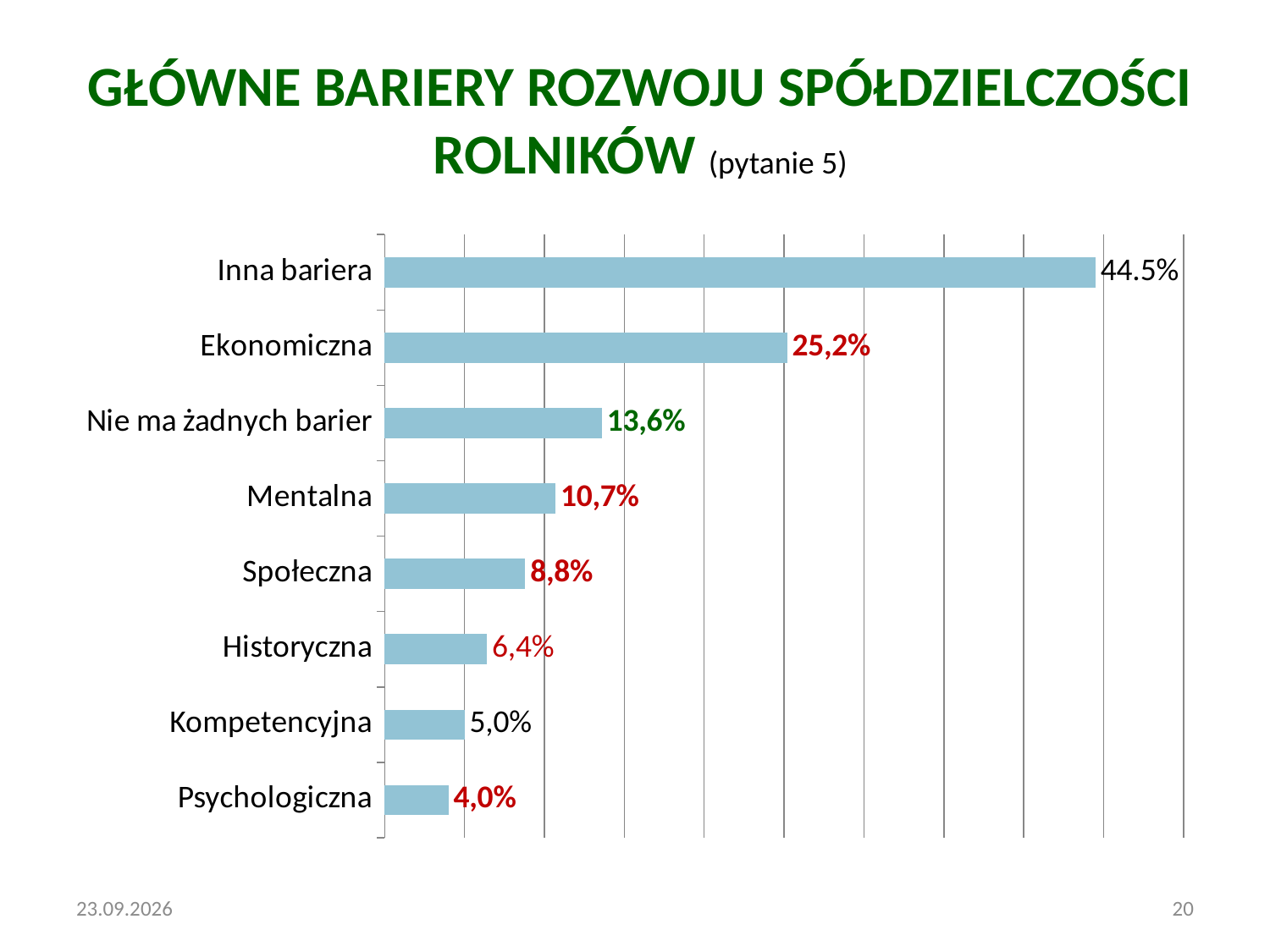
What is the value for Ekonomiczna? 25,2% Which category has the highest value? Inna bariera What is the difference between the values for Ekonomiczna and Mentalna? 14,5 percentage points What is the difference between the values for Społeczna and Historyczna? 2,4 percentage points Which question number does the chart title refer to? pytanie 5 Which is larger, the value for Mentalna or the value for Społeczna? Mentalna What kind of chart is shown on the slide? Bar chart How many categories are shown in the chart? 8 What is the value for Nie ma żadnych barier? 13,6% What is the value for Inna bariera? 44.5% Which category has the lowest value? Psychologiczna What is the value for Kompetencyjna? 5,0%